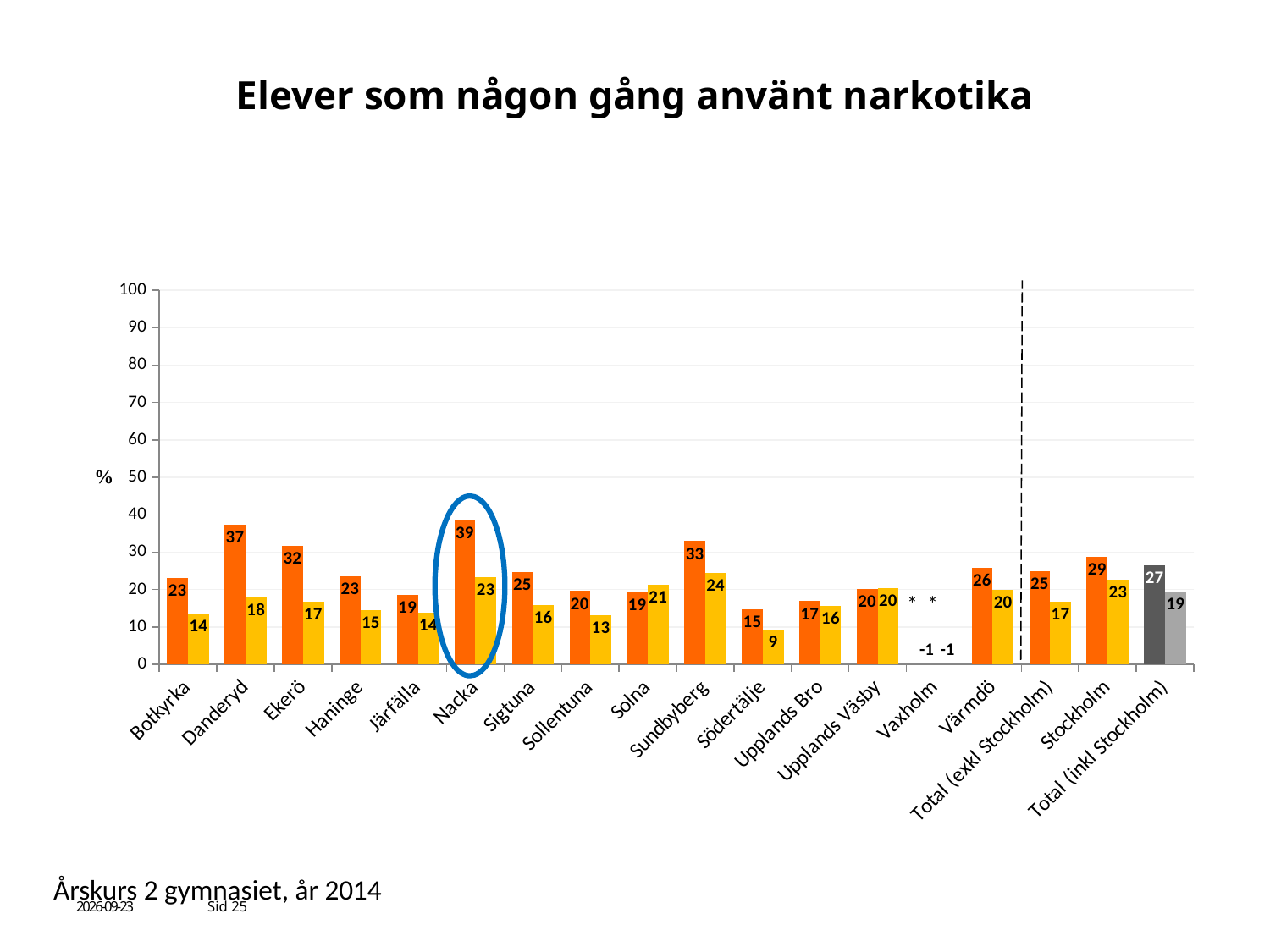
What is the value of the orange bar for Danderyd? 37 What is the value of the yellow bar for Södertälje? 9 Which municipality has the highest orange bar? Nacka Which municipality has the lowest yellow bar? Södertälje Which is larger for Solna, the orange bar or the yellow bar? the yellow bar What is the difference between the orange and yellow bars for Nacka? 16 What kind of chart is shown on the slide? bar chart How many categories are shown on the x axis? 18 What is the title of the chart? Elever som någon gång använt narkotika Is the orange bar for Sundbyberg greater or less than 30? greater What is the value of the orange bar for Nacka? 39